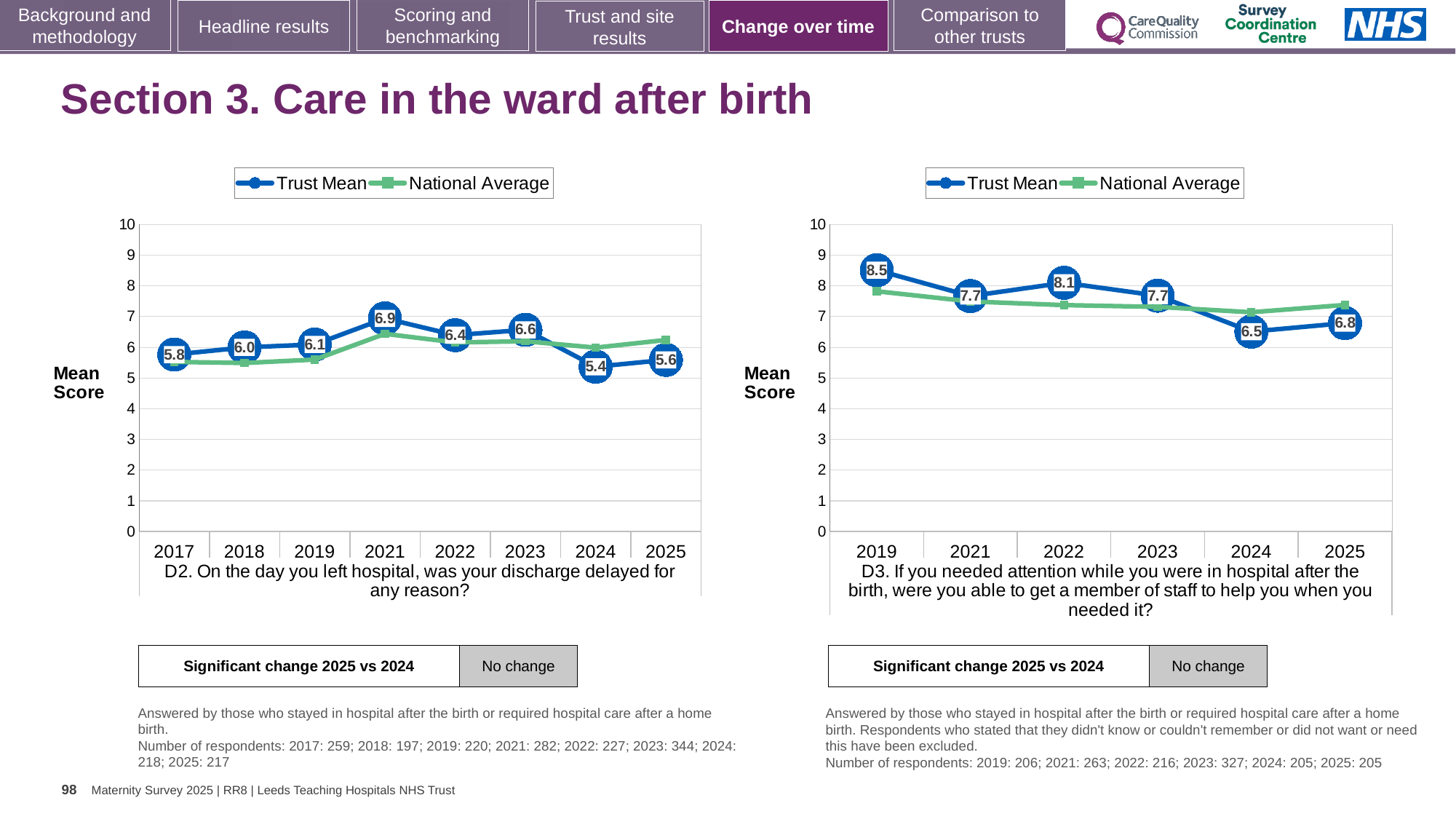
In the D3 chart (right), what is the Trust Mean for 2019? 8.5 In the D3 chart (right), what is the difference between the Trust Mean in 2019 and in 2024? 2.0 In the D2 chart (left), which year has the highest Trust Mean? 2021 In the D2 chart (left), what is the Trust Mean for 2021? 6.9 How many series does the legend of the D3 chart (right) list? 2 How many years are plotted on the x axis of the D2 chart (left)? 8 In the D3 chart (right), what is the Trust Mean for 2025? 6.8 What type of chart is used for the D3 chart (right)? Line chart In the D3 chart (right), is the National Average for 2019 greater or less than 7? greater In the D2 chart (left), what is the Trust Mean for 2024? 5.4 In the D2 chart (left), is the Trust Mean higher in 2023 or in 2025? 2023 In the D3 chart (right), which year has the lowest Trust Mean? 2024